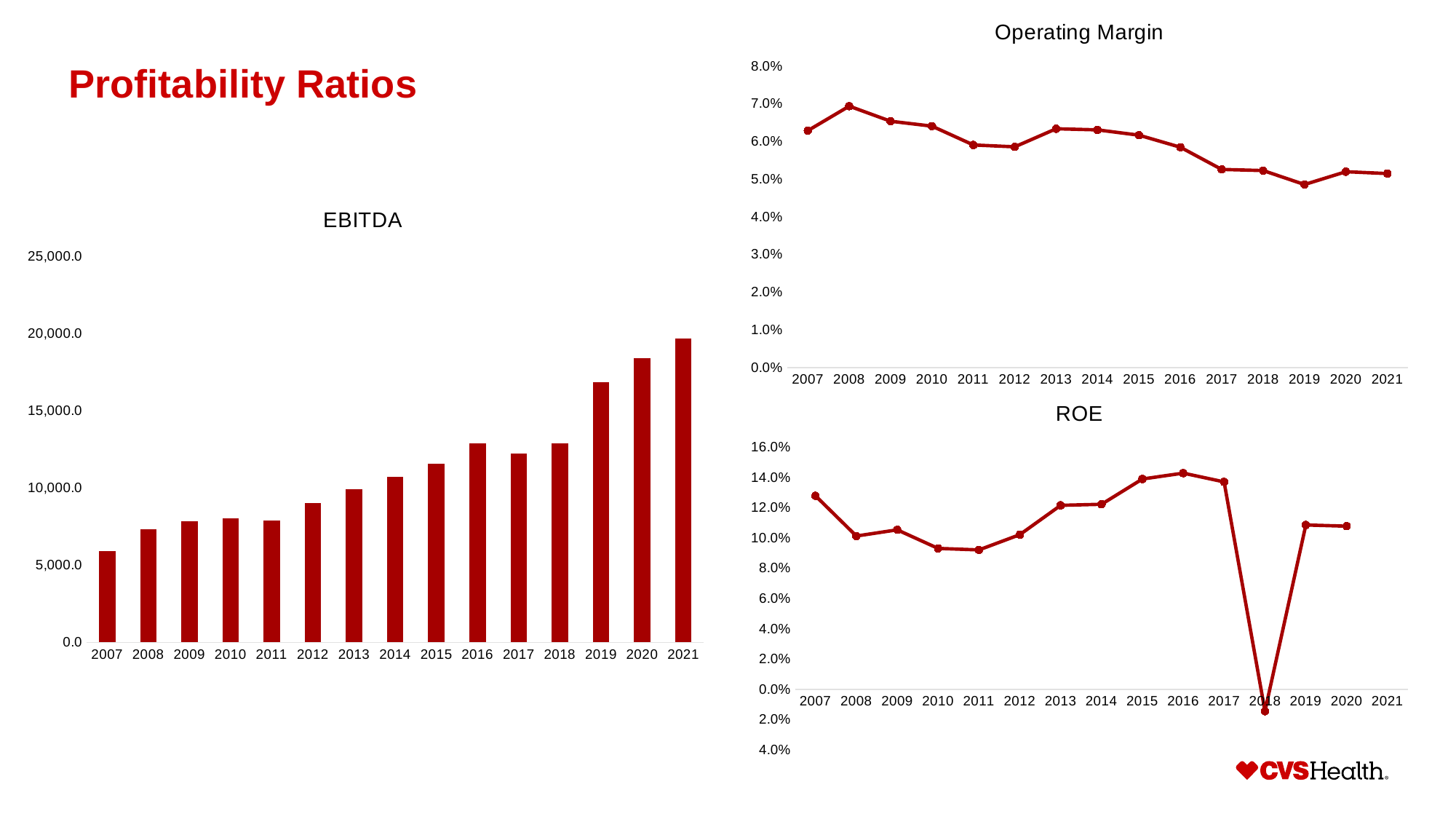
In the ROE chart, which year has the lowest value? 2018 In the Operating Margin chart, which year has the highest value? 2008 In the EBITDA chart, is the value for 2019 larger than the value for 2018? yes In the EBITDA chart, is the value for 2021 greater or less than 15,000.0? greater In the EBITDA chart, which year has the highest value? 2021 What kind of chart is the Operating Margin chart? line chart In the Operating Margin chart, is the value for 2019 greater or less than 5.0%? less What kind of chart is the EBITDA chart? bar chart How many years are shown on the x axis of the EBITDA chart? 15 In the EBITDA chart, which year has the lowest value? 2007 In the Operating Margin chart, which year has the lowest value? 2019 In the Operating Margin chart, do values generally rise or fall from 2008 to 2019? fall